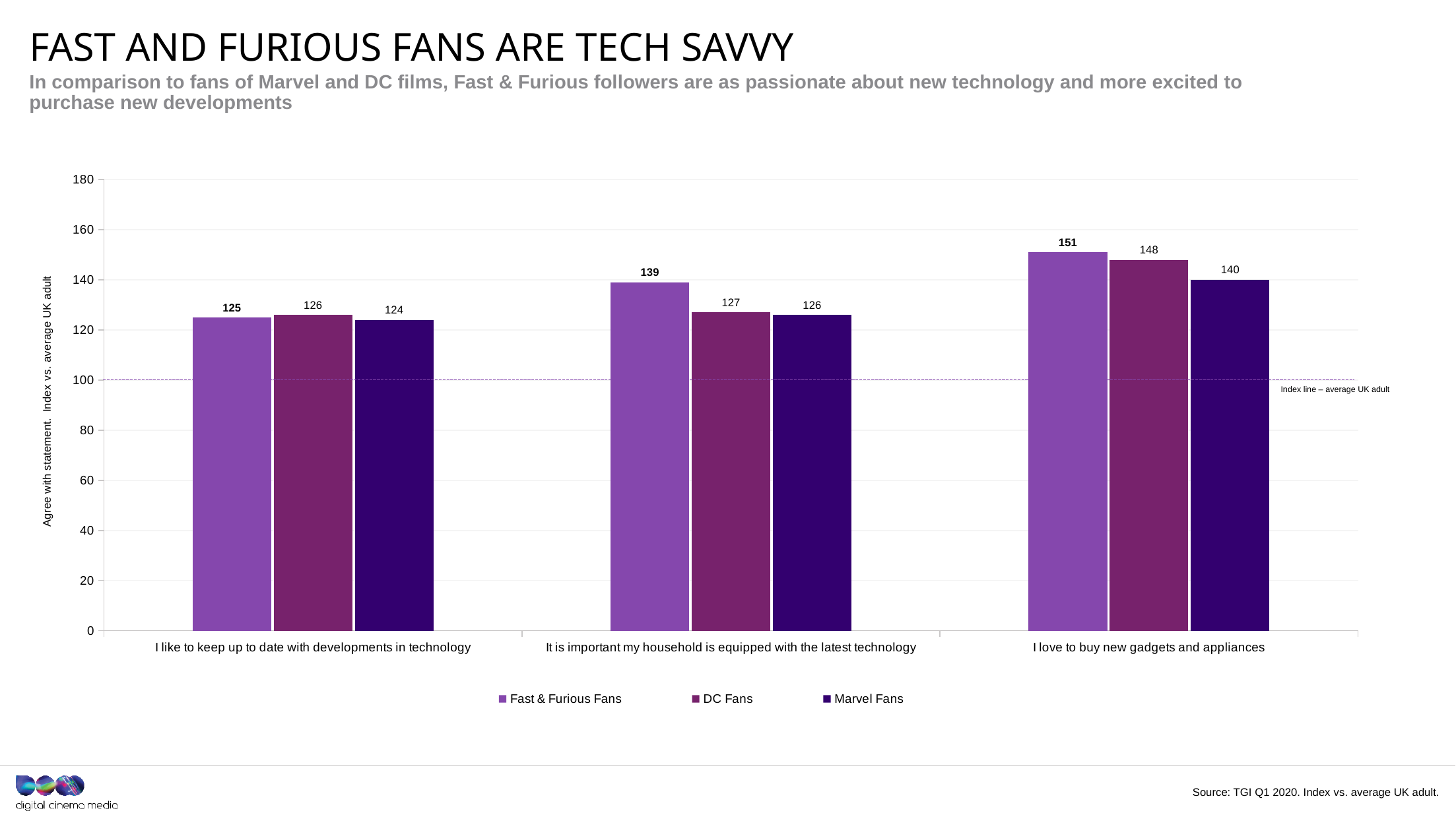
What is the value for DC Fans for 'It is important my household is equipped with the latest technology'? 127 What is the value for Fast & Furious Fans for 'I love to buy new gadgets and appliances'? 151 How many series does the legend list? 3 Is the value for DC Fans for 'I love to buy new gadgets and appliances' greater or less than 140? greater How many statements (categories) are shown on the x axis? 3 Which statement has the lowest value for Marvel Fans? I like to keep up to date with developments in technology For 'It is important my household is equipped with the latest technology', which is larger: Fast & Furious Fans or DC Fans? Fast & Furious Fans What does the dashed horizontal line at 100 represent? Index line – average UK adult What is the value for Marvel Fans for 'I like to keep up to date with developments in technology'? 124 What is the difference between Fast & Furious Fans and Marvel Fans for 'I love to buy new gadgets and appliances'? 11 Which statement has the highest value for Fast & Furious Fans? I love to buy new gadgets and appliances What kind of chart is shown on the slide? Bar chart